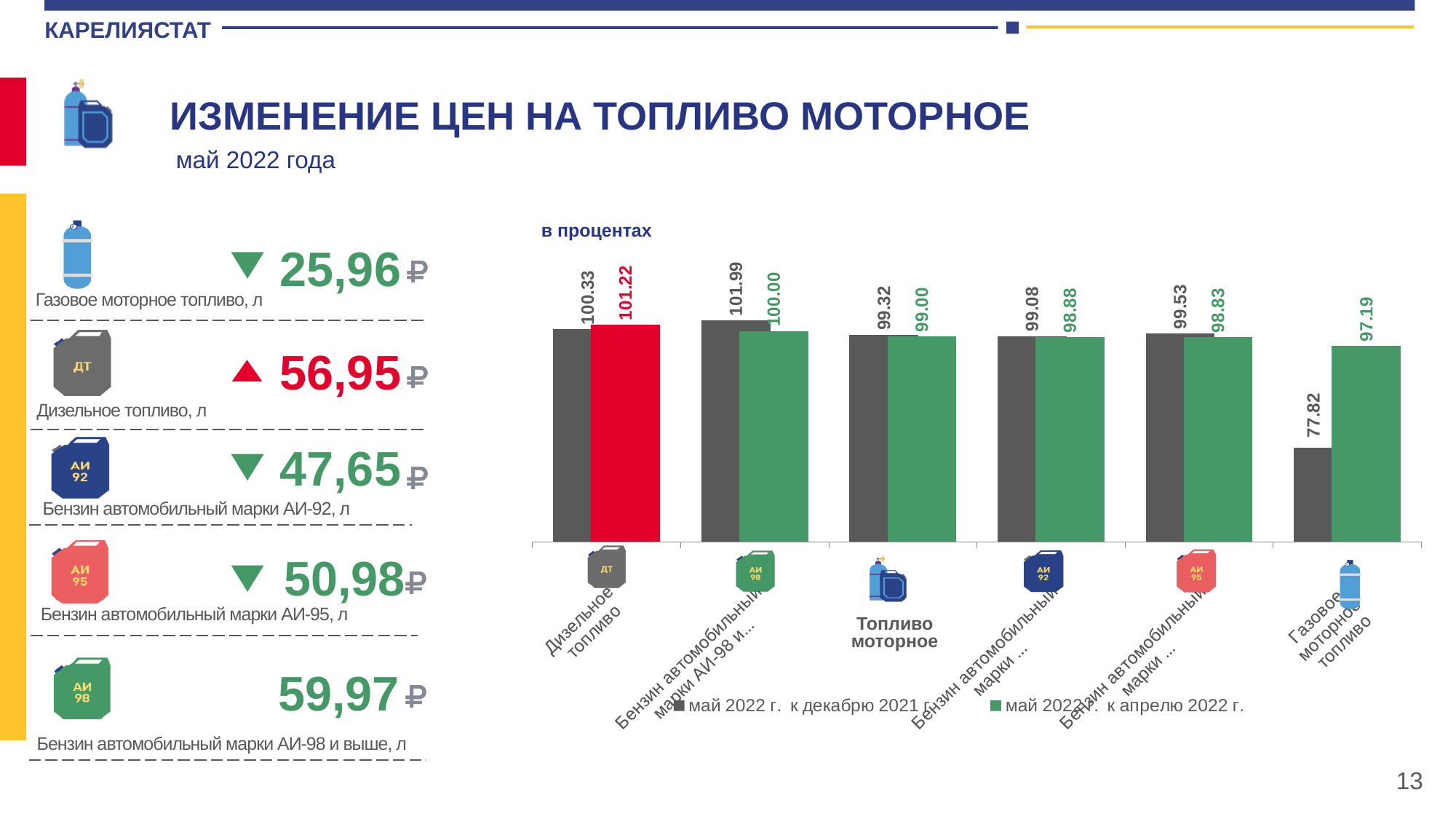
Which category has the lowest value in the series 'май 2022 г. к декабрю 2021 г.'? Газовое моторное топливо For Дизельное топливо, which series has the larger value: 'май 2022 г. к декабрю 2021 г.' or 'май 2022 г. к апрелю 2022 г.'? май 2022 г. к апрелю 2022 г. For Газовое моторное топливо, what is the difference between the 'май 2022 г. к апрелю 2022 г.' value and the 'май 2022 г. к декабрю 2021 г.' value? 19.37 Which category has the highest value in the series 'май 2022 г. к апрелю 2022 г.'? Дизельное топливо How many categories are shown on the x axis of the chart? 6 How many series does the chart legend list? 2 What is the value for Дизельное топливо in the series 'май 2022 г. к декабрю 2021 г.'? 100.33 What is the value for Газовое моторное топливо in the series 'май 2022 г. к декабрю 2021 г.'? 77.82 What is the value for Топливо моторное in the series 'май 2022 г. к апрелю 2022 г.'? 99.00 What is the value for Дизельное топливо in the series 'май 2022 г. к апрелю 2022 г.'? 101.22 What kind of chart is shown on the slide? bar chart What is the value for Газовое моторное топливо in the series 'май 2022 г. к апрелю 2022 г.'? 97.19